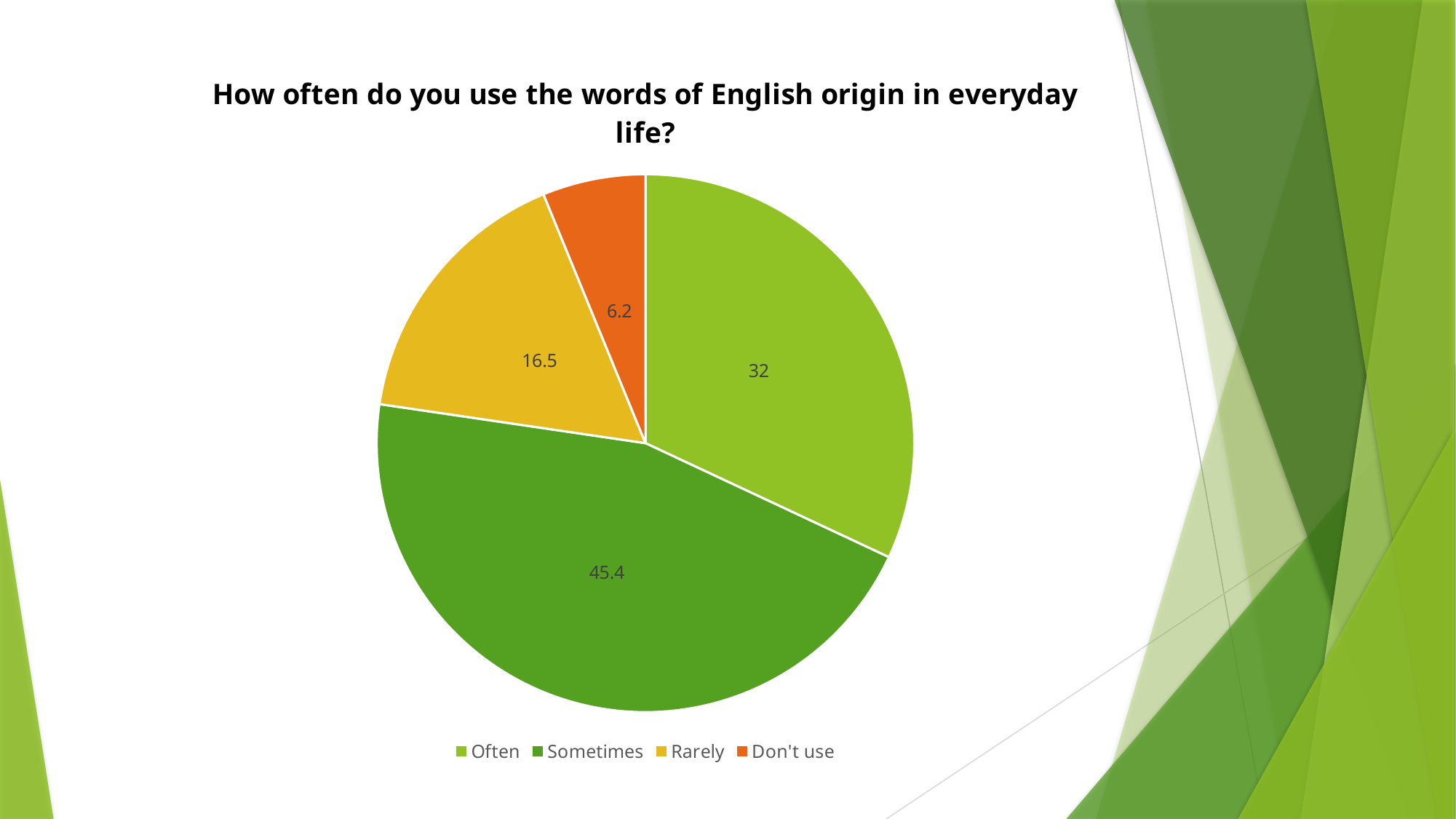
Which is larger, the value for Often or the value for Rarely? Often What is the value for Sometimes? 45.4 What is the difference between the values for Rarely and Don't use? 10.3 What is the value for Don't use? 6.2 Which category has the largest slice? Sometimes How many categories does the pie chart show? 4 What kind of chart is shown on the slide? Pie chart What is the difference between the values for Sometimes and Often? 13.4 What is the title of the chart? How often do you use the words of English origin in everyday life? What is the value for Often? 32 What is the value for Rarely? 16.5 Which category has the smallest slice? Don't use